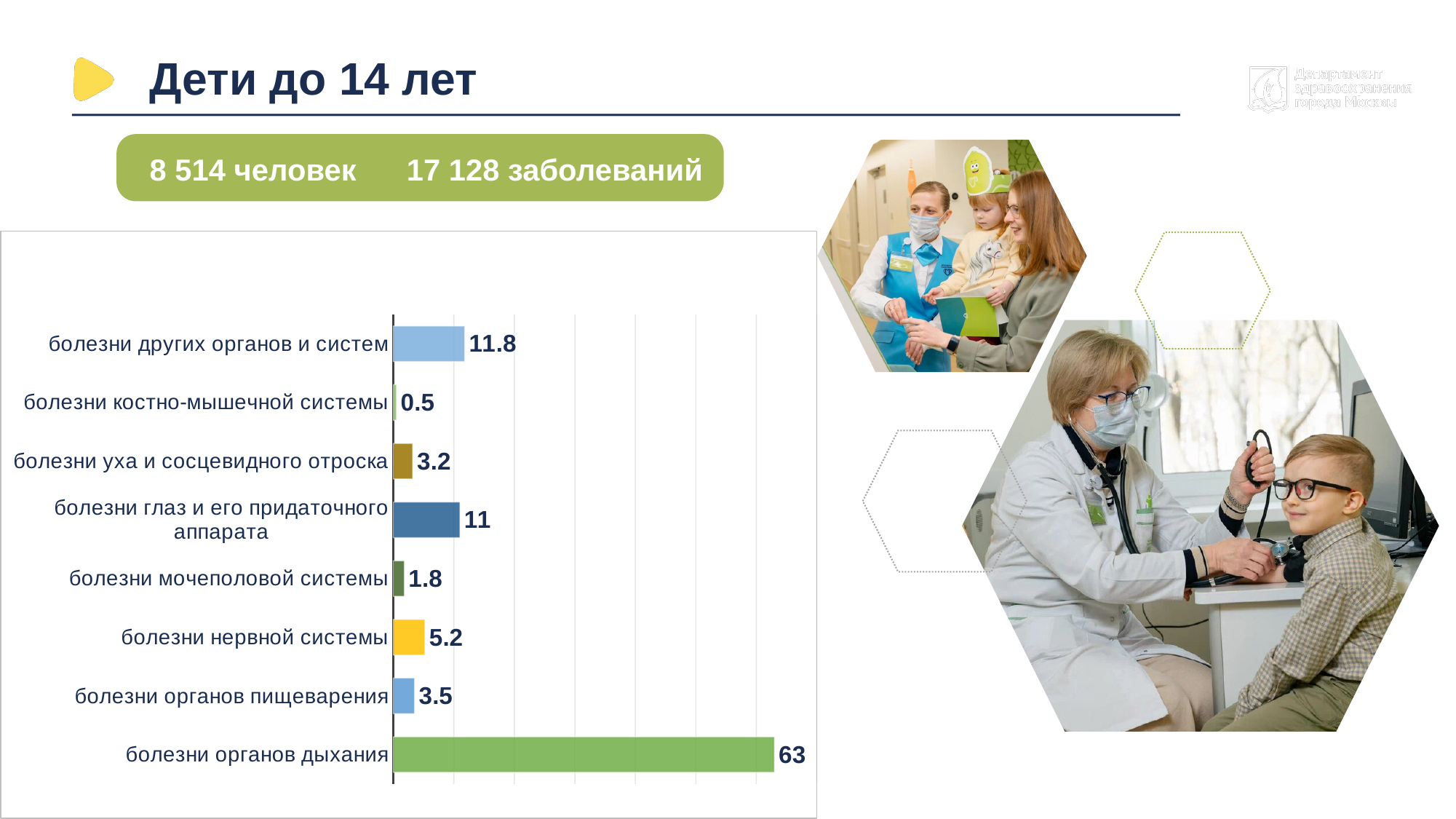
How many categories are shown in the chart? 8 Which is larger, the value for болезни органов пищеварения or the value for болезни уха и сосцевидного отроска? болезни органов пищеварения What is the value for болезни костно-мышечной системы? 0.5 What is the value for болезни глаз и его придаточного аппарата? 11 What is the value for болезни нервной системы? 5.2 Which category has the lowest value? болезни костно-мышечной системы What kind of chart is shown on the slide? bar chart What is the value for болезни органов дыхания? 63 What is the difference between the values for болезни нервной системы and болезни мочеполовой системы? 3.4 What is the difference between the values for болезни органов дыхания and болезни других органов и систем? 51.2 What colour is the bar for болезни нервной системы? yellow Which category has the highest value? болезни органов дыхания